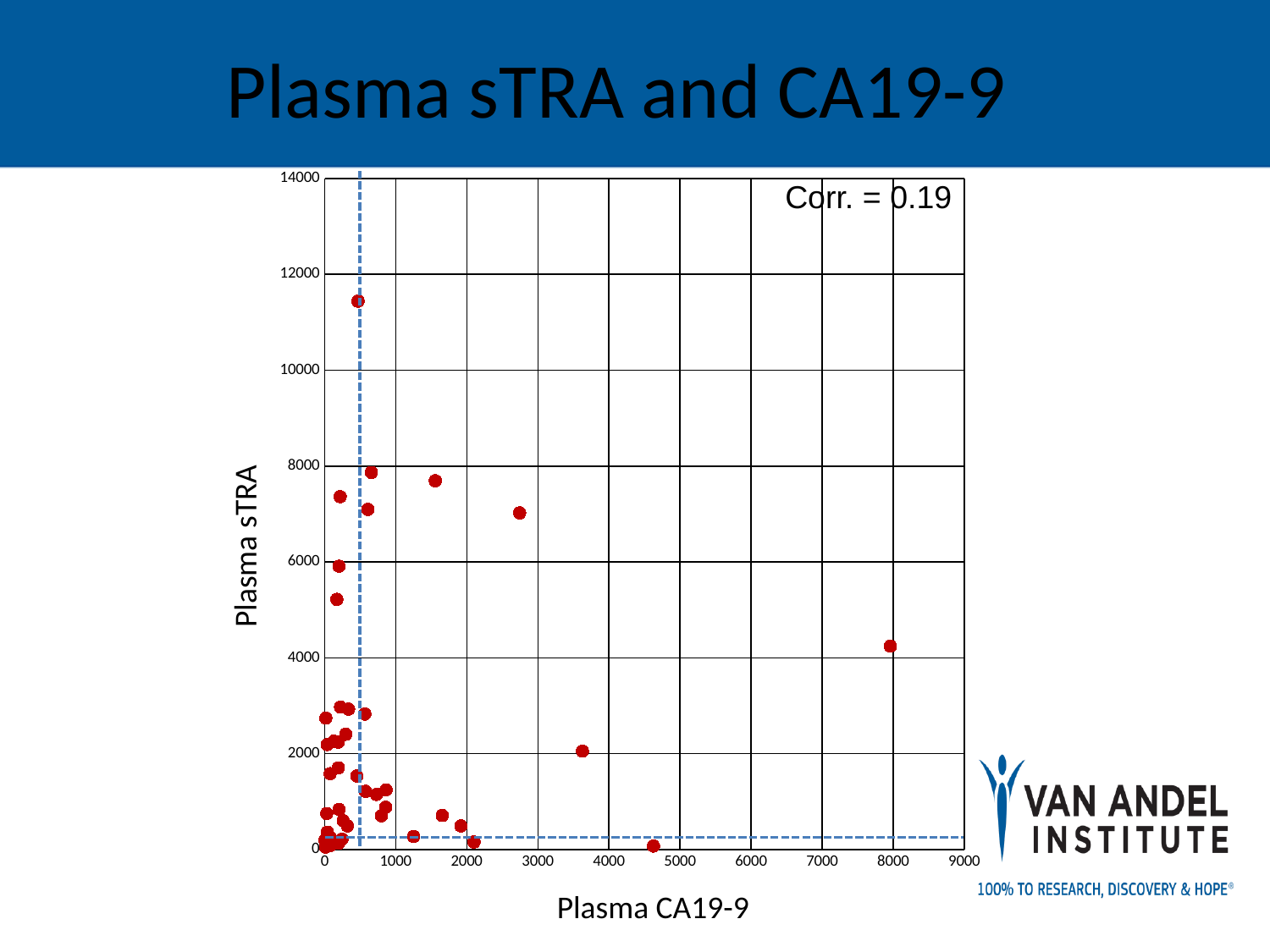
Is the Plasma CA19-9 value of the rightmost point greater or less than 7000? greater Is the Plasma sTRA value of the point with Plasma CA19-9 between 4000 and 5000 greater or less than 2000? less Is the Plasma CA19-9 value of the point with the highest Plasma sTRA greater or less than 1000? less What kind of chart is shown on the slide? scatter plot What is the label of the vertical axis? Plasma sTRA What correlation value is printed on the chart? 0.19 What is the title of the chart? Plasma sTRA and CA19-9